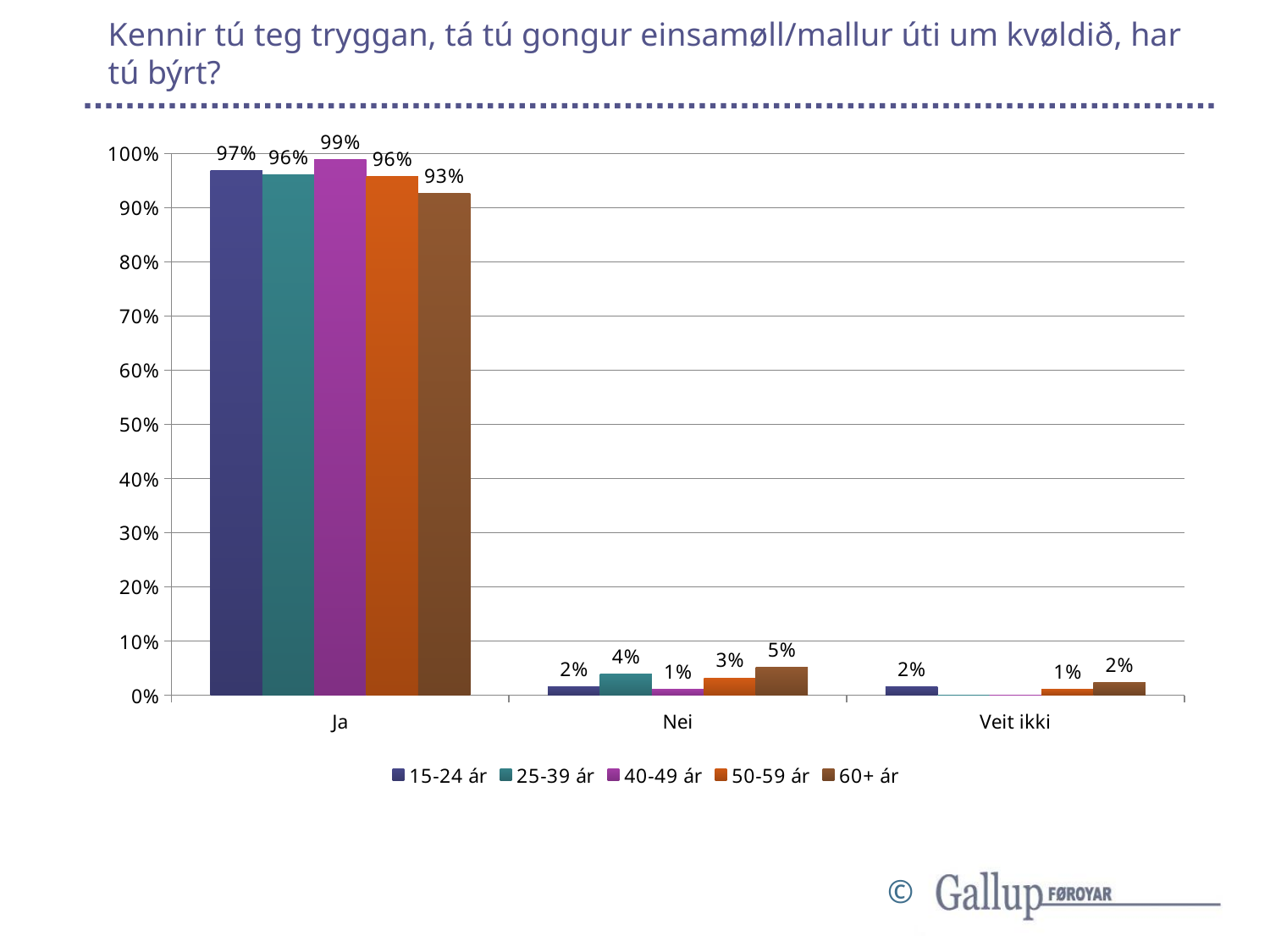
What kind of chart is shown on the slide? Bar chart What percentage of the 40-49 ár group answered Ja? 99% Which is larger for Nei: the value for 25-39 ár or the value for 50-59 ár? 25-39 ár Which age group has the highest value for Ja? 40-49 ár How many series does the legend list? 5 What is the difference between the Ja values for 40-49 ár and 60+ ár? 6% How many answer categories are shown on the x axis? 3 Which age group has the lowest value for Ja? 60+ ár What percentage of the 60+ ár group answered Nei? 5% What percentage of the 15-24 ár group answered Ja? 97% Which age group has the highest value for Nei? 60+ ár What percentage of the 50-59 ár group answered Veit ikki? 1%